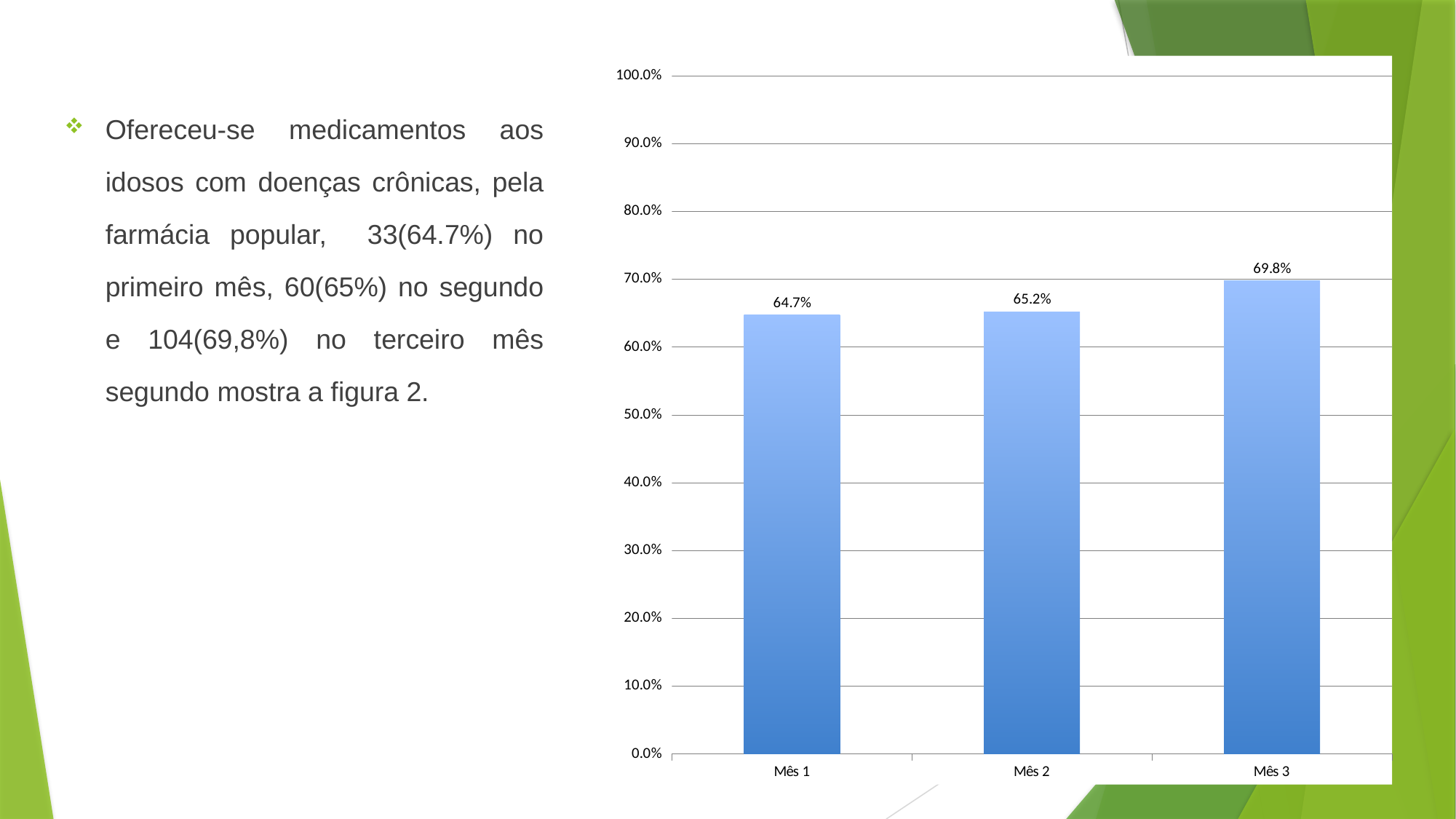
How many months are shown on the x axis? 3 Is the value for Mês 1 greater or less than 60.0%? greater What is the value for Mês 3? 69.8% Which month has the lowest value? Mês 1 What is the value for Mês 2? 65.2% Do the values rise or fall from Mês 1 to Mês 3? rise What kind of chart is shown on the slide? bar chart Which is larger, the value for Mês 3 or the value for Mês 1? Mês 3 What is the value for Mês 1? 64.7% Which month has the highest value? Mês 3 What is the difference between the values for Mês 3 and Mês 1? 5.1 percentage points What is the difference between the values for Mês 3 and Mês 2? 4.6 percentage points